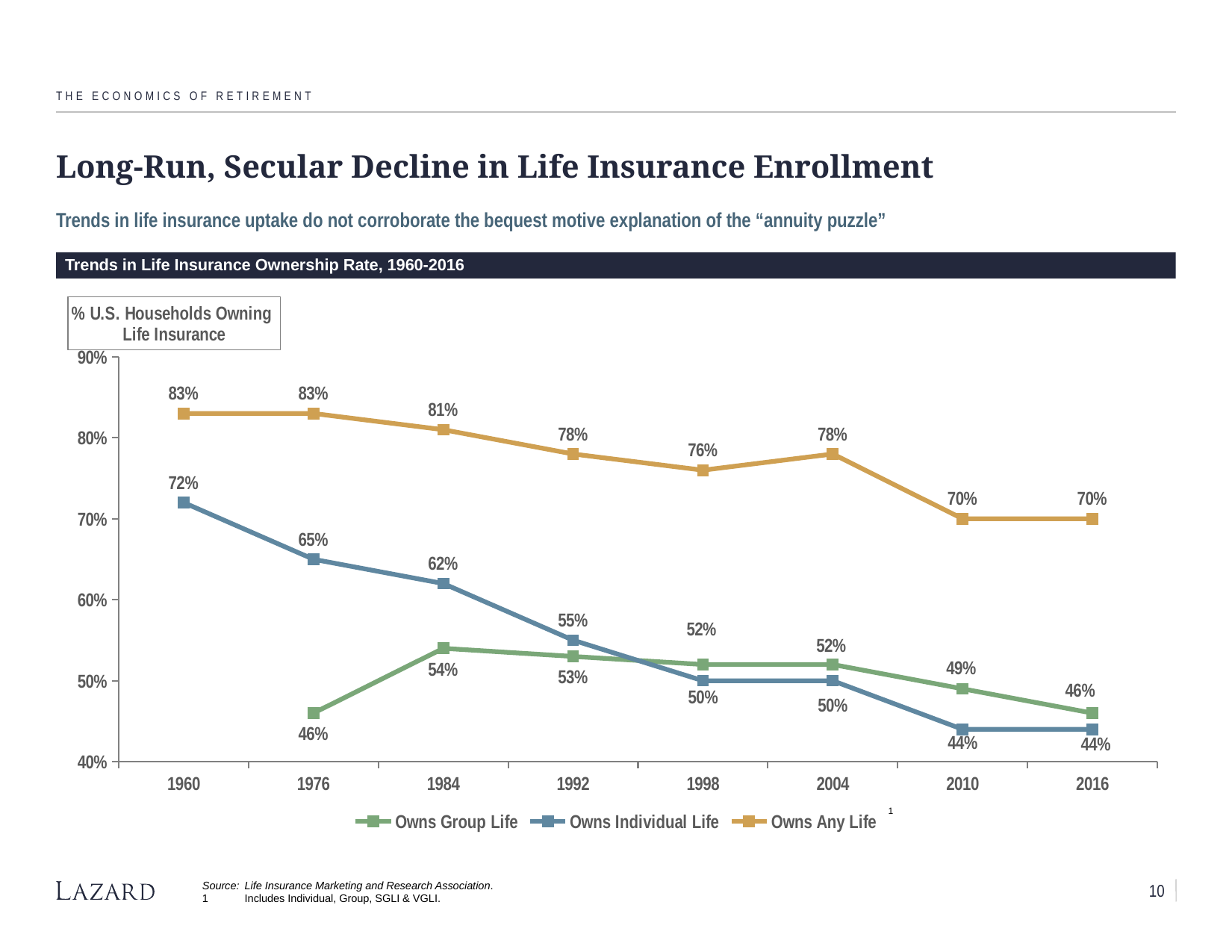
How many years are shown on the x axis? 8 By how many percentage points did Owns Any Life fall from 1960 to 2016? 13 percentage points What is the value for Owns Any Life in 1960? 83% What kind of chart is shown on the slide? line chart In which year is the Owns Group Life series at its highest? 1984 Is the value for Owns Any Life in 2004 greater or less than 80%? less What is the value for Owns Individual Life in 1992? 55% What is the value for Owns Group Life in 1984? 54% What is the lowest value shown for the Owns Any Life series? 70% In which year is the Owns Individual Life series at its highest? 1960 In 1998, which is larger: Owns Group Life or Owns Individual Life? Owns Group Life How many series does the legend list? 3